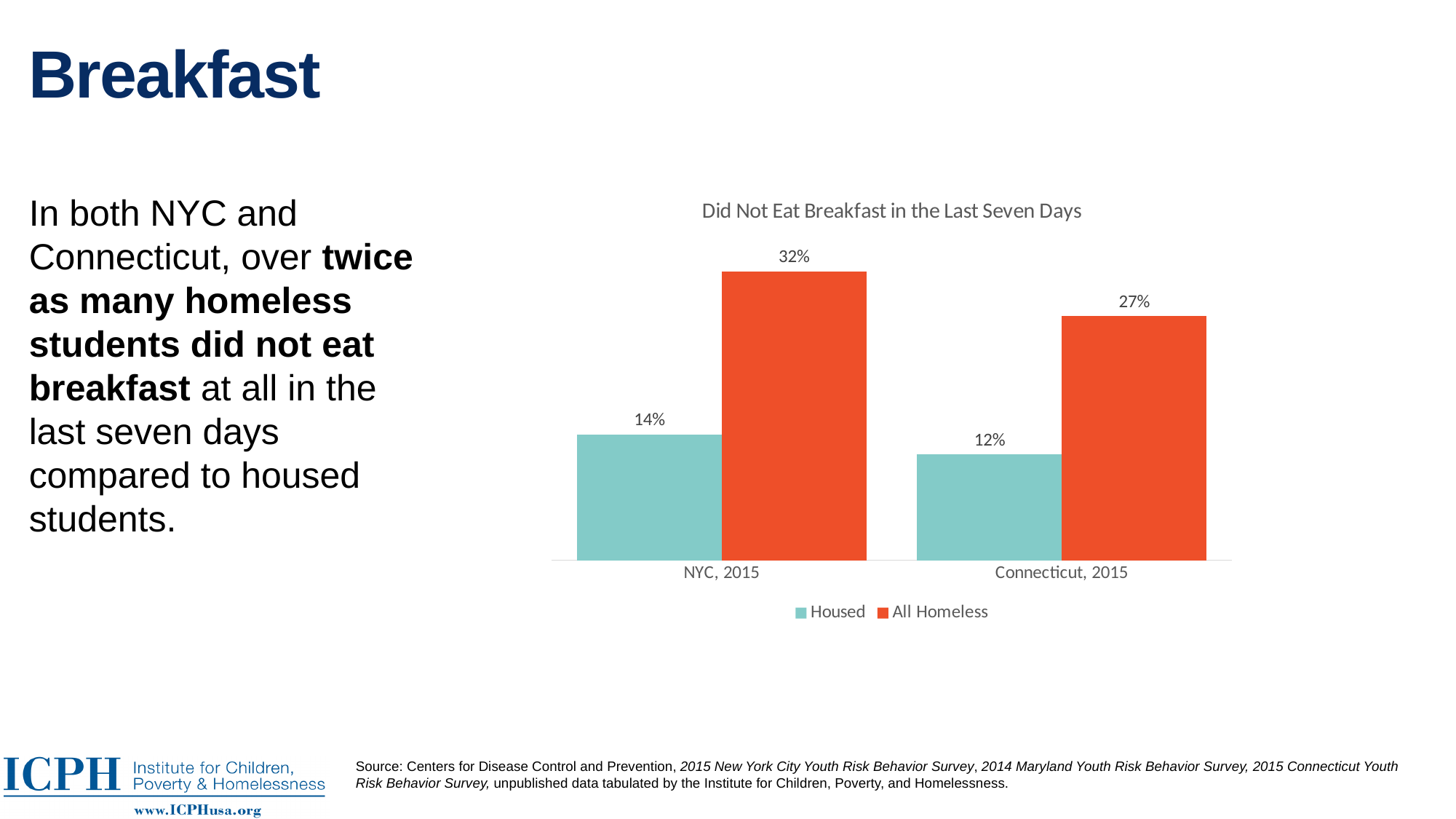
What is the difference between the All Homeless and Housed values for Connecticut, 2015? 15% How many series does the chart legend list? 2 Which bar in the chart has the highest value? All Homeless, NYC, 2015 What percentage of housed students in Connecticut, 2015 did not eat breakfast in the last seven days? 12% What percentage of all homeless students in Connecticut, 2015 did not eat breakfast in the last seven days? 27% What is the difference between the All Homeless and Housed values for NYC, 2015? 18% Which bar in the chart has the lowest value? Housed, Connecticut, 2015 What type of chart is shown on the slide? Bar chart Which is larger: the All Homeless value for NYC, 2015 or the All Homeless value for Connecticut, 2015? NYC, 2015 What percentage of all homeless students in NYC, 2015 did not eat breakfast in the last seven days? 32% How many categories are shown on the x axis of the chart? 2 What percentage of housed students in NYC, 2015 did not eat breakfast in the last seven days? 14%